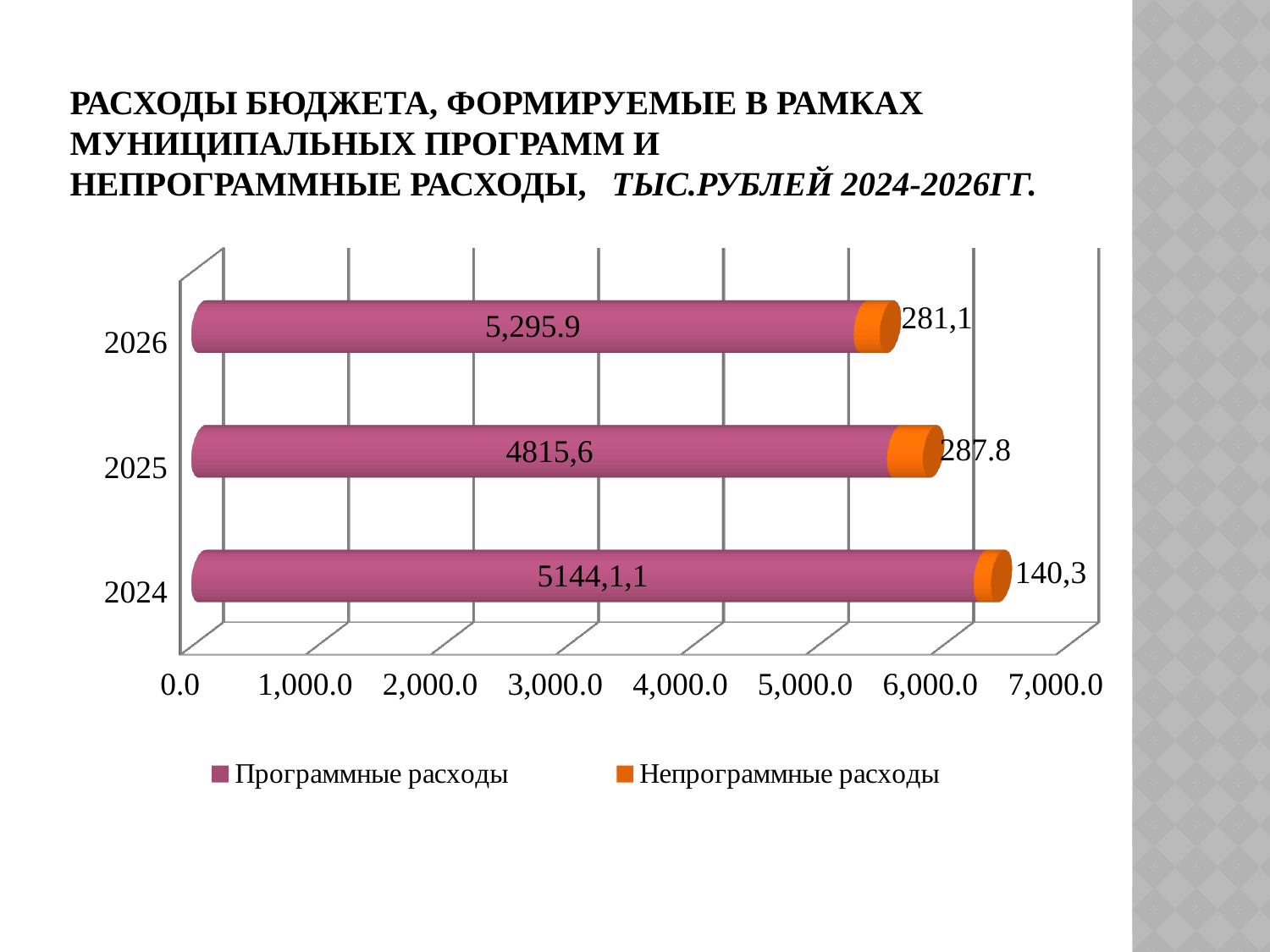
Which year has the lowest value of Непрограммные расходы? 2024 What is the value of Программные расходы for 2026? 5,295.9 How many series does the legend list? 2 What is the value of Программные расходы for 2025? 4815,6 What colour represents Непрограммные расходы in the chart? orange What is the value of Непрограммные расходы for 2024? 140,3 How many years are shown on the chart? 3 What kind of chart is shown on the slide? bar chart What is the value of Непрограммные расходы for 2025? 287.8